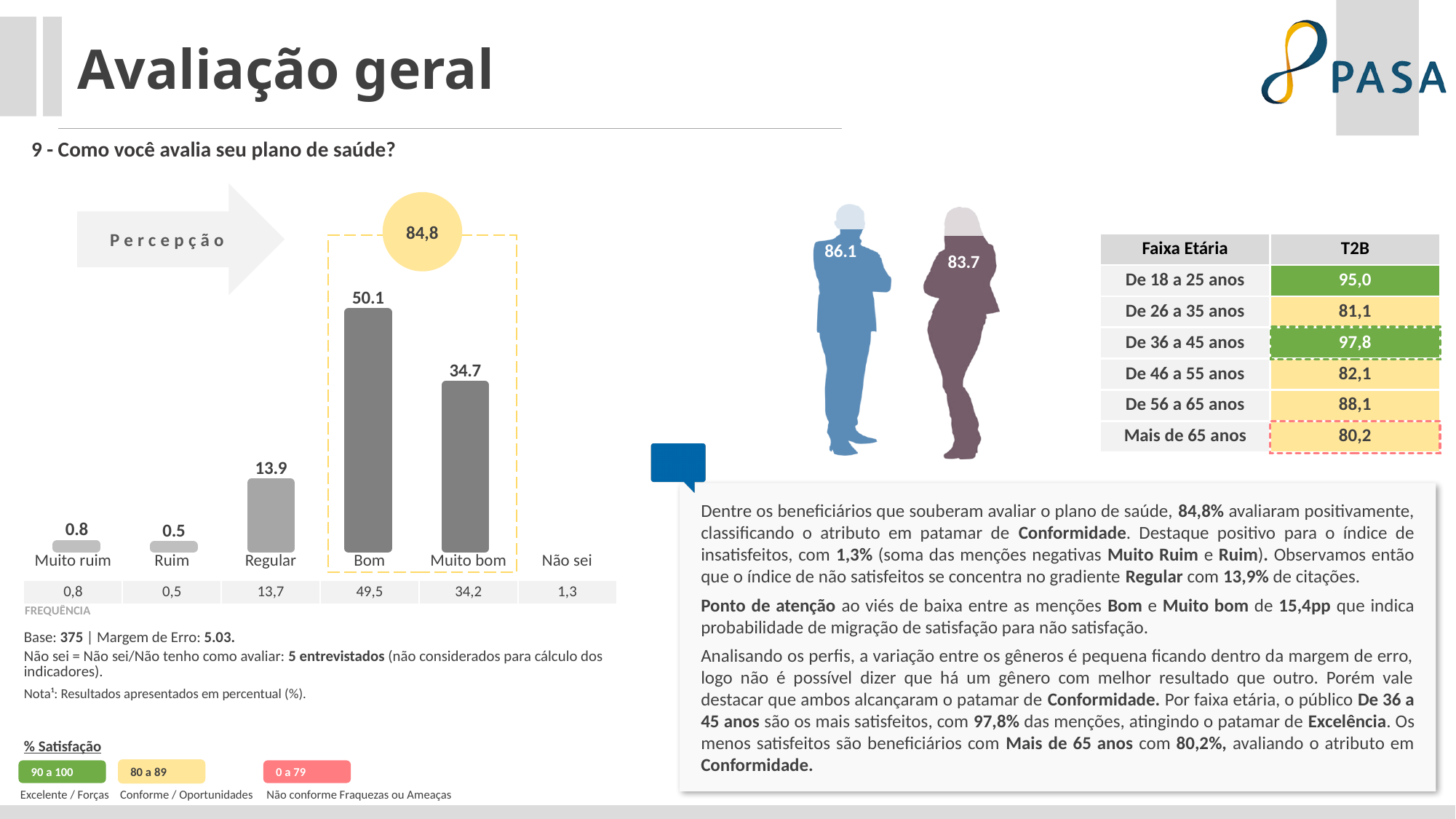
In the bar chart, what is the value for Regular? 13.9 What value is shown in the yellow circle above the Bom and Muito bom bars? 84,8 What is the difference between the values for Bom and Muito bom in the bar chart? 15.4 In the bar chart, what is the value for Muito ruim? 0.8 In the bar chart, what is the value for Bom? 50.1 What kind of chart is used to show the answers to "Como você avalia seu plano de saúde?"? bar chart Do the values rise or fall going from Ruim to Bom along the x axis? rise In the bar chart, what is the value for Muito bom? 34.7 How many bars are plotted in the bar chart? 5 Which category has the highest value in the bar chart? Bom Which category has the lowest value among the plotted bars? Ruim Which is larger in the bar chart, Regular or Muito bom? Muito bom